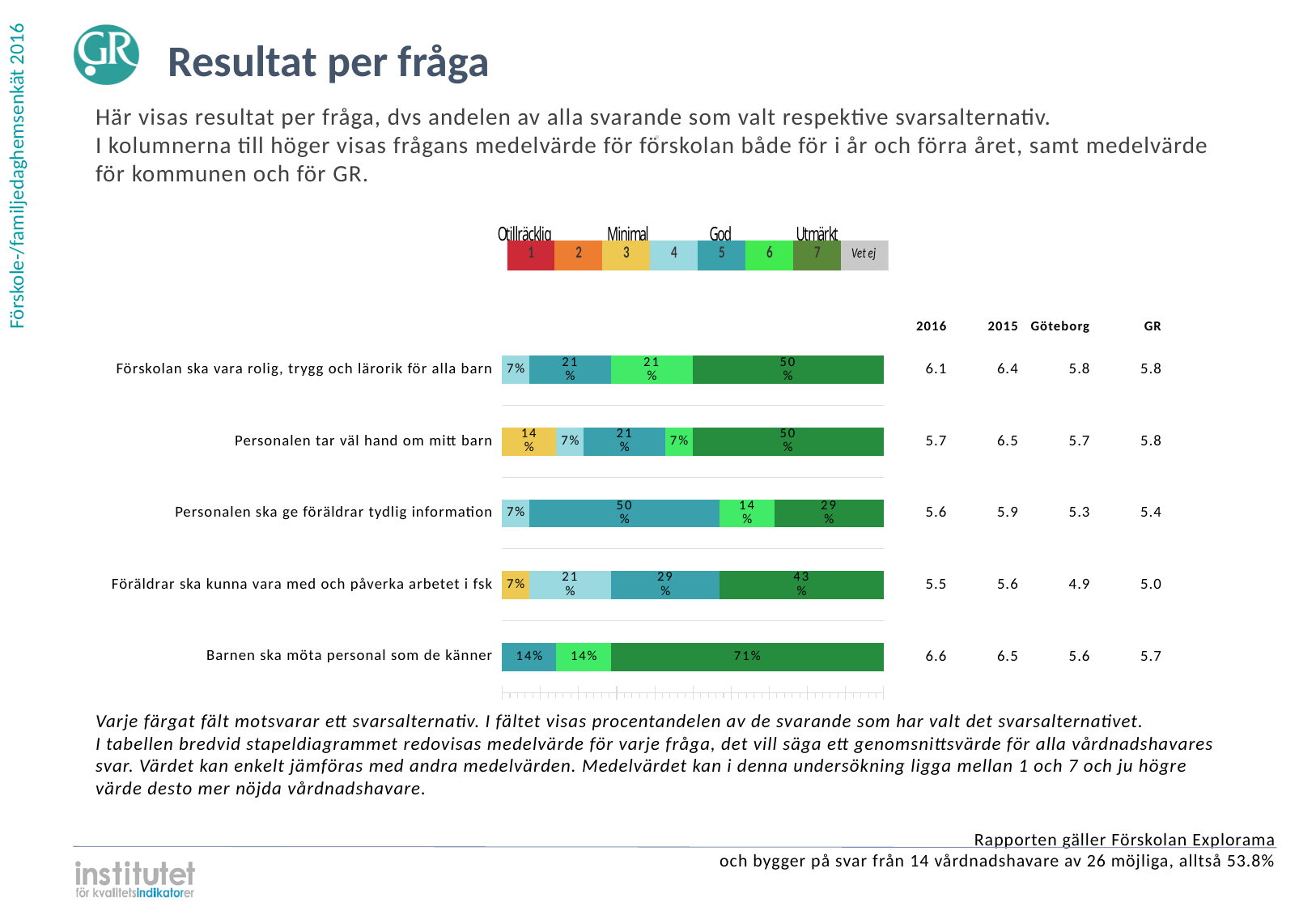
What percentage of respondents chose the dark green (7) option for 'Förskolan ska vara rolig, trygg och lärorik för alla barn'? 50% What label does the legend give to the value 7? Utmärkt Which question has the largest share of respondents choosing the dark green (7) option? Barnen ska möta personal som de känner What percentage of respondents chose the dark green (7, Utmärkt) option for 'Barnen ska möta personal som de känner'? 71% Which question has the smallest share of respondents choosing the dark green (7) option? Personalen ska ge föräldrar tydlig information How many questions (bars) are shown in the chart? 5 What is the Göteborg mean value for 'Föräldrar ska kunna vara med och påverka arbetet i fsk'? 4.9 What percentage of respondents chose the teal (5) option for 'Personalen ska ge föräldrar tydlig information'? 50% Is the dark green (7) share for 'Föräldrar ska kunna vara med och påverka arbetet i fsk' larger or smaller than the dark green share for 'Personalen tar väl hand om mitt barn'? Smaller What is the difference between the 2015 and 2016 mean values for 'Förskolan ska vara rolig, trygg och lärorik för alla barn'? 0.3 What kind of chart is shown on the slide? Stacked bar chart What is the 2016 mean value for 'Barnen ska möta personal som de känner'? 6.6